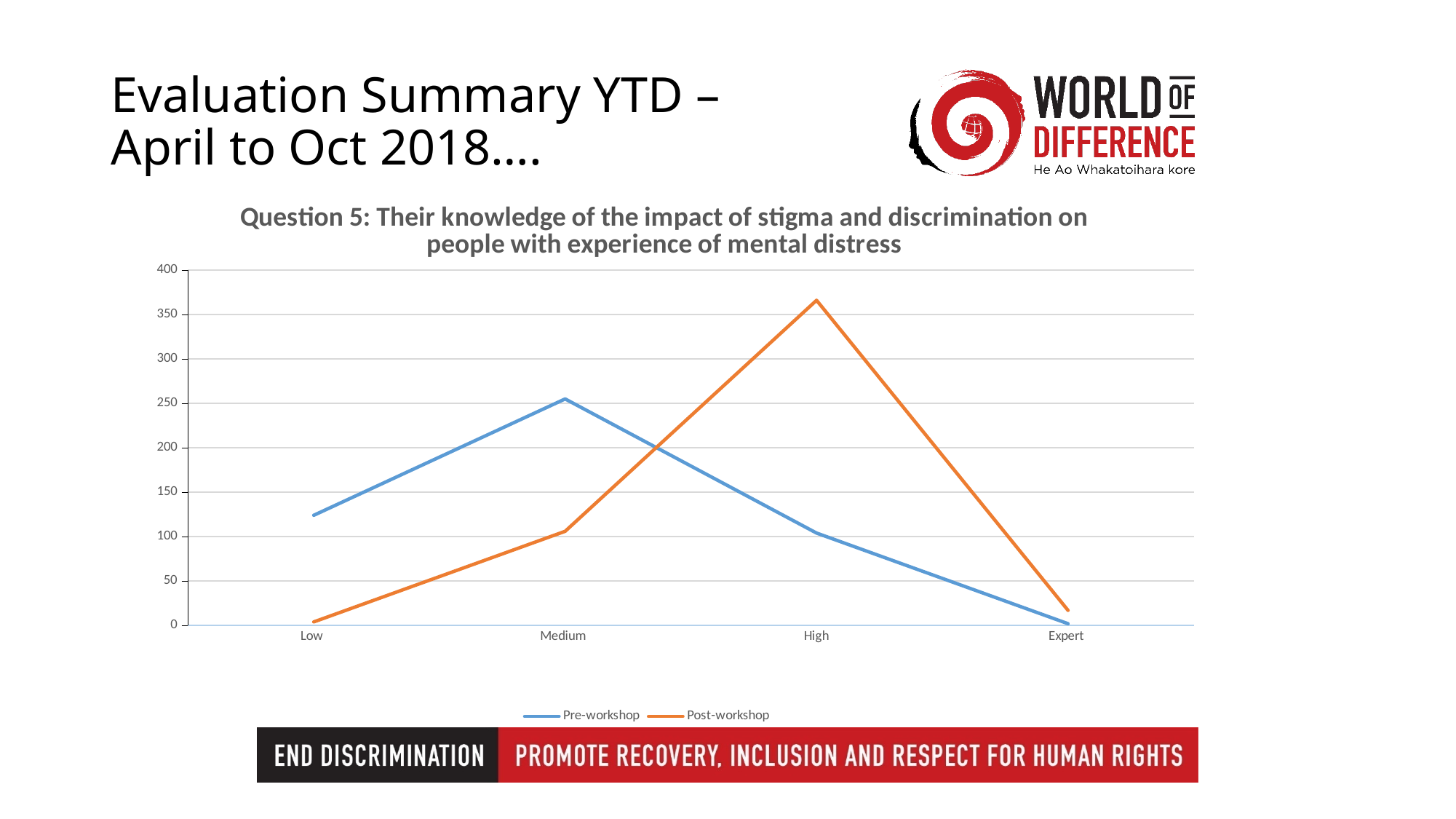
Which category has the highest Post-workshop value? High Which category has the lowest Post-workshop value? Low Is the Pre-workshop value for Low greater or less than 150? less How many series does the legend list? 2 Which category has the lowest Pre-workshop value? Expert What kind of chart is shown on the slide? line chart Which category has the highest Pre-workshop value? Medium How many categories are shown on the x axis? 4 For the High category, which series has the larger value, Pre-workshop or Post-workshop? Post-workshop Is the Post-workshop value for High greater or less than 350? greater For the Medium category, which series has the larger value, Pre-workshop or Post-workshop? Pre-workshop Which series is drawn in orange? Post-workshop